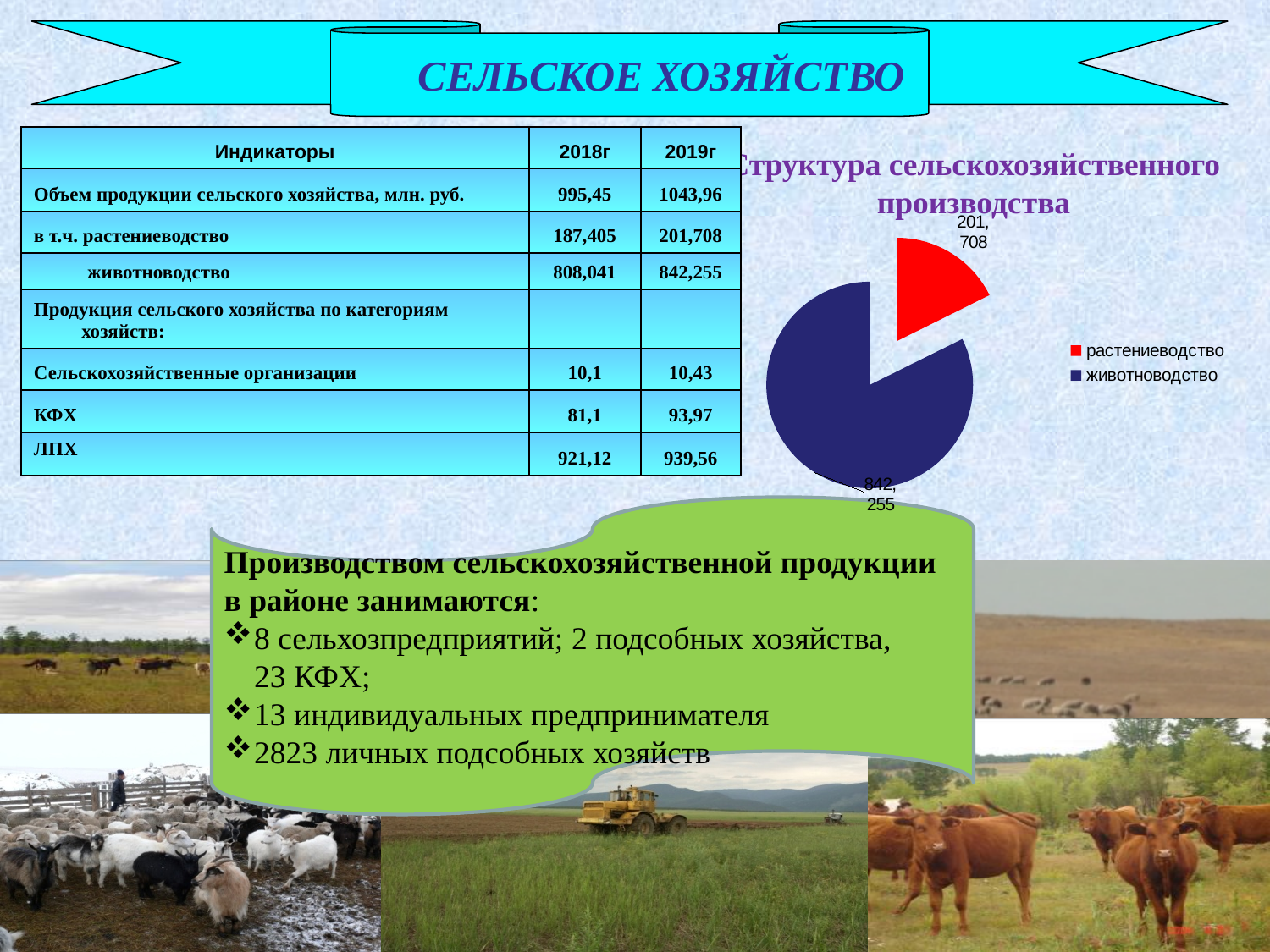
How many series does the legend of the pie chart list? 2 What is the difference between the животноводство and растениеводство values in the pie chart? 640,547 How many slices does the pie chart have? 2 What kind of chart is shown on the slide? pie chart What is the value shown for животноводство in the pie chart? 842,255 Which slice of the pie chart is the smallest? растениеводство What is the value shown for растениеводство in the pie chart? 201,708 What is the title of the pie chart? Структура сельскохозяйственного производства Which colour represents животноводство in the pie chart? dark blue Which slice of the pie chart is the largest? животноводство In the pie chart, which is larger: растениеводство or животноводство? животноводство What is the total of the two values shown in the pie chart? 1043,963